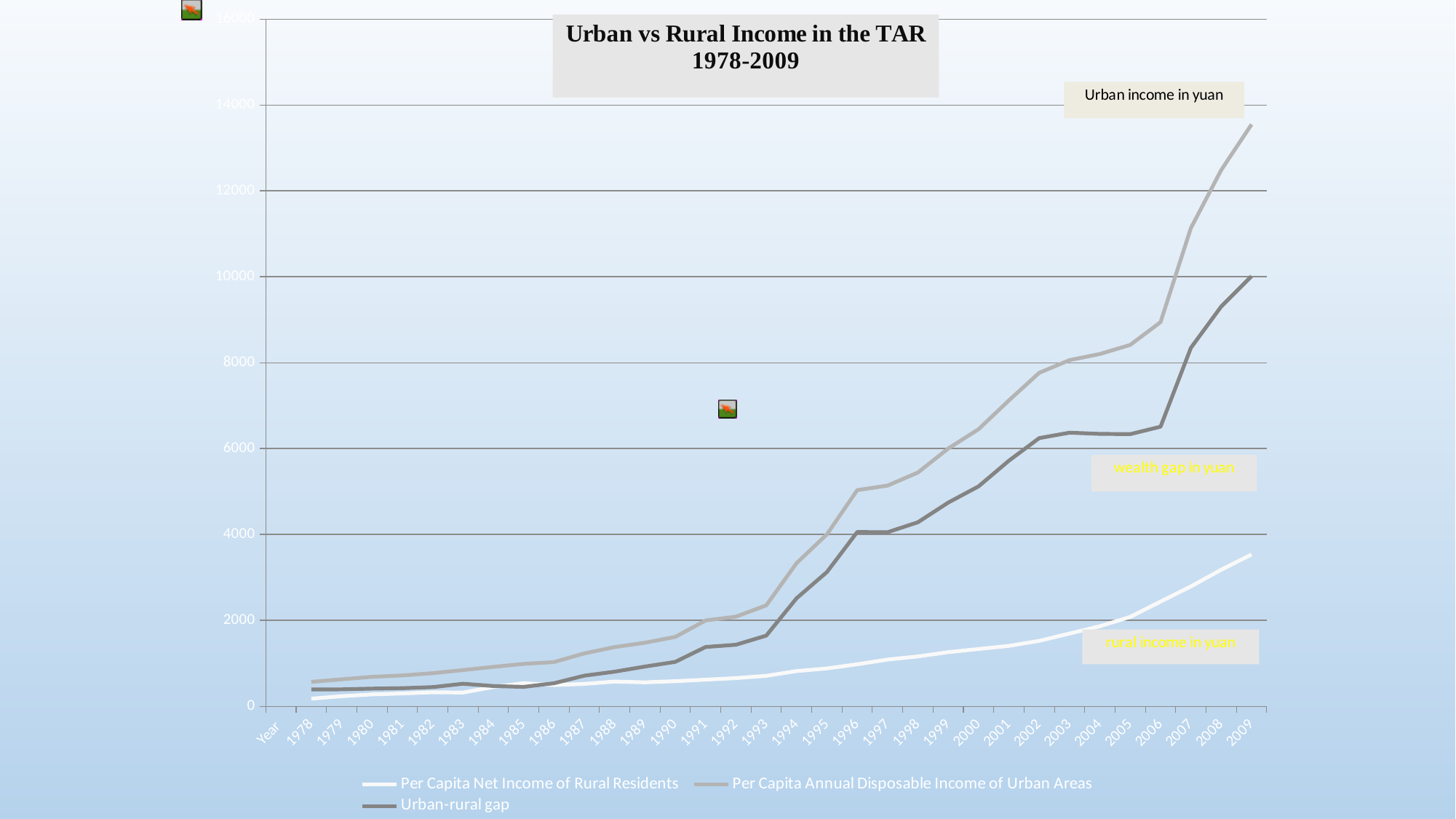
Is the value for Per Capita Annual Disposable Income of Urban Areas in 1996 greater or less than 4000? greater What is the title of the chart? Urban vs Rural Income in the TAR 1978-2009 Is the value for Per Capita Net Income of Rural Residents in 1978 greater or less than 2000? less Is the value for Per Capita Annual Disposable Income of Urban Areas in 2009 greater or less than 12000? greater Do the values for Per Capita Annual Disposable Income of Urban Areas rise or fall from 1978 to 2009? rise In 2009, which is larger: Per Capita Annual Disposable Income of Urban Areas or Per Capita Net Income of Rural Residents? Per Capita Annual Disposable Income of Urban Areas Which series is plotted with the white line? Per Capita Net Income of Rural Residents Which series has the highest value in 2009? Per Capita Annual Disposable Income of Urban Areas How many series does the legend list? 3 What kind of chart is shown on the slide? line chart